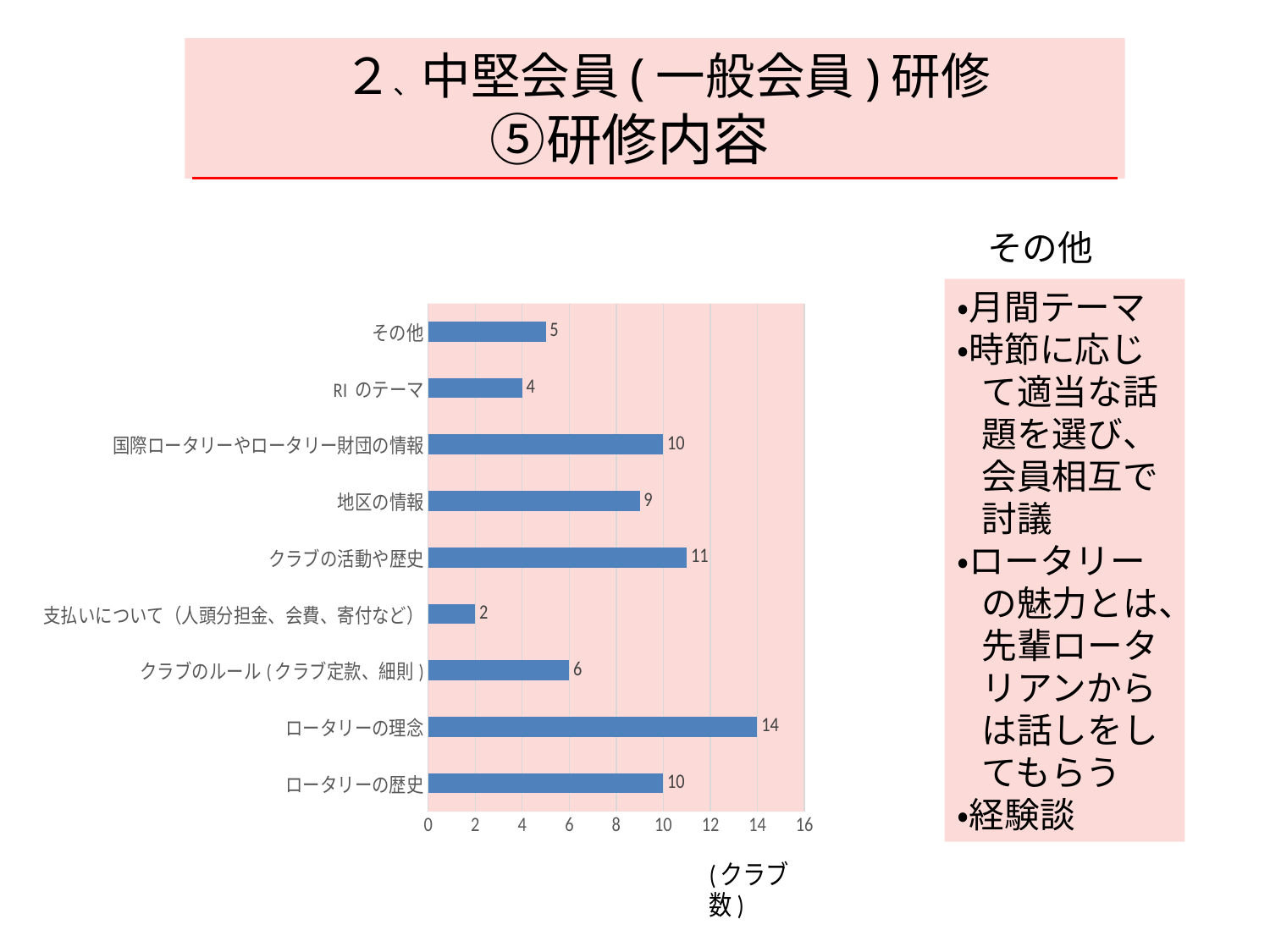
What is the difference between the values for ロータリーの理念 and クラブの活動や歴史? 3 Is the value for 国際ロータリーやロータリー財団の情報 greater or less than 8? greater Which category has the highest value? ロータリーの理念 What kind of chart is shown on the slide? bar chart What unit label is shown below the x axis of the chart? (クラブ数) What is the value for 支払いについて（人頭分担金、会費、寄付など）? 2 What is the value for ロータリーの理念? 14 Which category has the lowest value? 支払いについて（人頭分担金、会費、寄付など） What is the value for RI のテーマ? 4 What is the value for 地区の情報? 9 Which is larger, the value for クラブのルール (クラブ定款、細則) or the value for その他? クラブのルール (クラブ定款、細則) How many categories are shown in the chart? 9